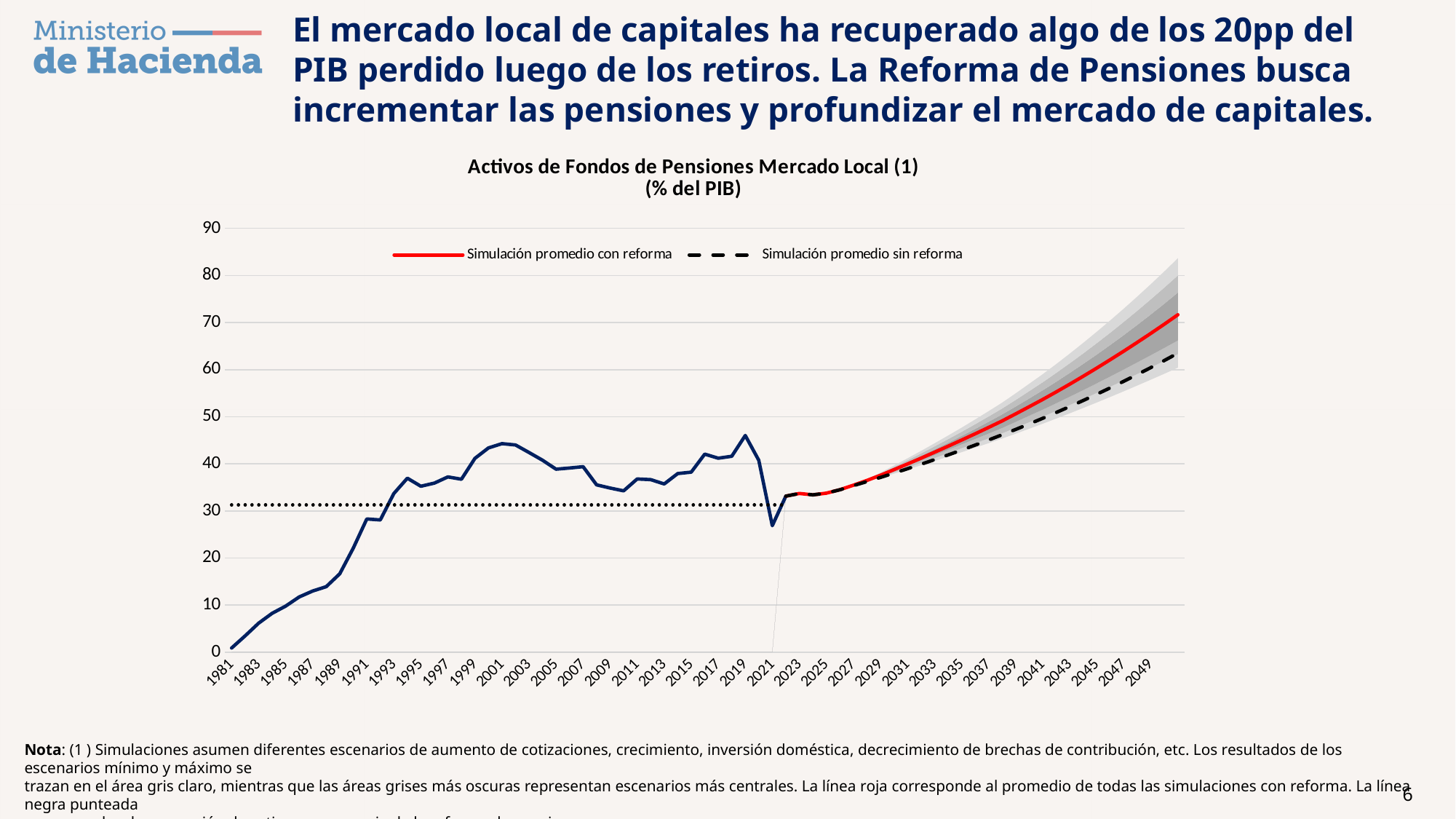
How many series does the chart legend list? 2 What kind of chart is shown on the slide? line chart Is the value for 2019 greater or less than 40? greater In 2049, which series is higher: 'Simulación promedio con reforma' or 'Simulación promedio sin reforma'? Simulación promedio con reforma Do the simulated values rise or fall from 2023 to 2049? rise What colour is the line for 'Simulación promedio con reforma'? red Is the value for 1989 greater or less than 20? less Is the value for 1981 greater or less than 10? less What is the title of the chart? Activos de Fondos de Pensiones Mercado Local (1) (% del PIB) Which year has the higher value, 2019 or 2021? 2019